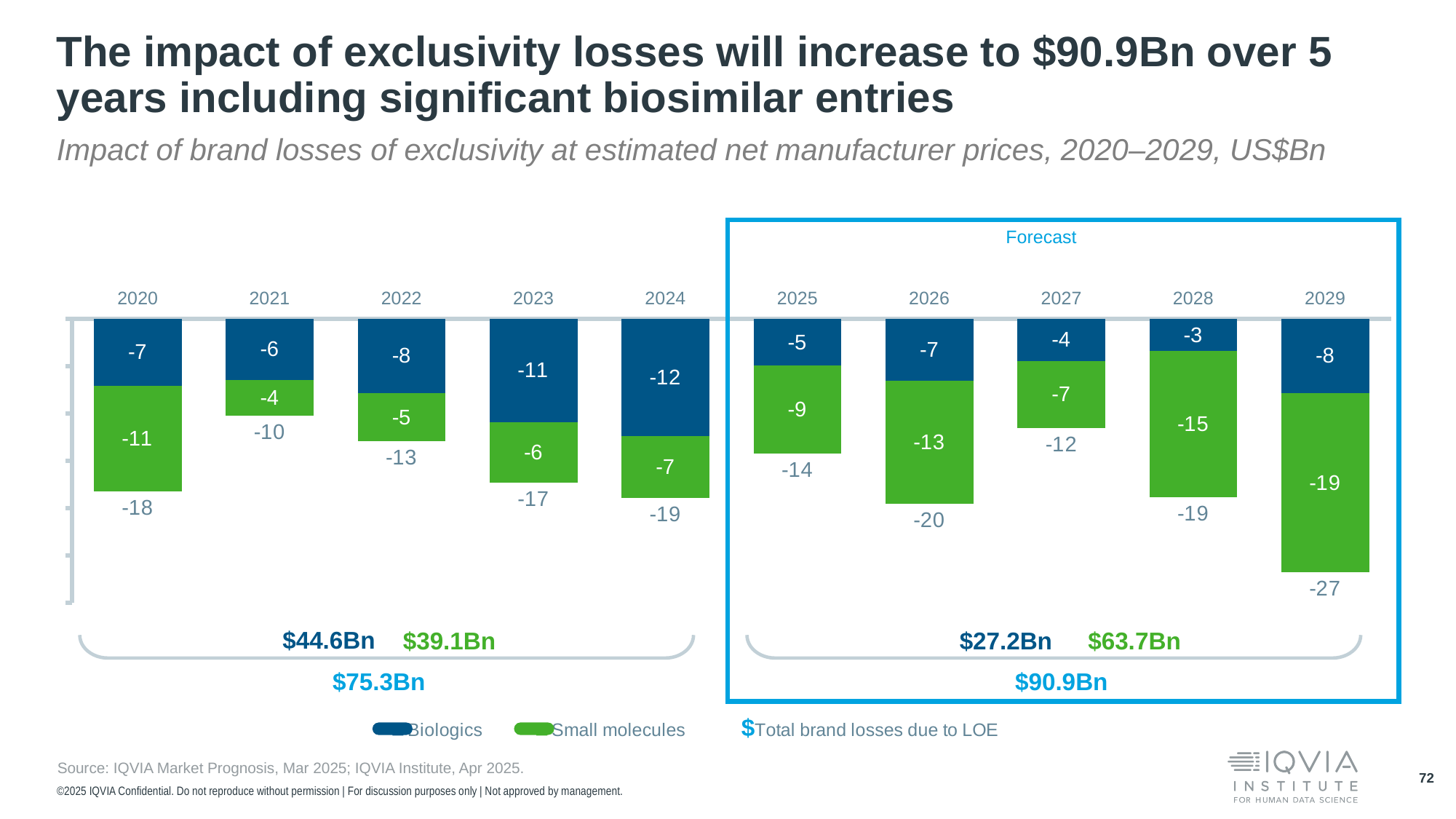
What is the total brand loss shown for 2026? -20 What is the Small molecules value for 2029? -19 Which is larger in magnitude for 2023: the Biologics loss or the Small molecules loss? Biologics Which year has the smallest total brand loss? 2021 What is the Biologics value for 2024? -12 What is the total brand loss due to LOE for the forecast period 2025–2029? $90.9Bn What kind of chart is shown? Stacked bar chart What is the difference between the Small molecules values for 2029 and 2028? 4 What is the Biologics total for 2020–2024? $44.6Bn How many years are shown on the x axis? 10 How many series does the legend list? 3 Which year has the largest total brand loss? 2029